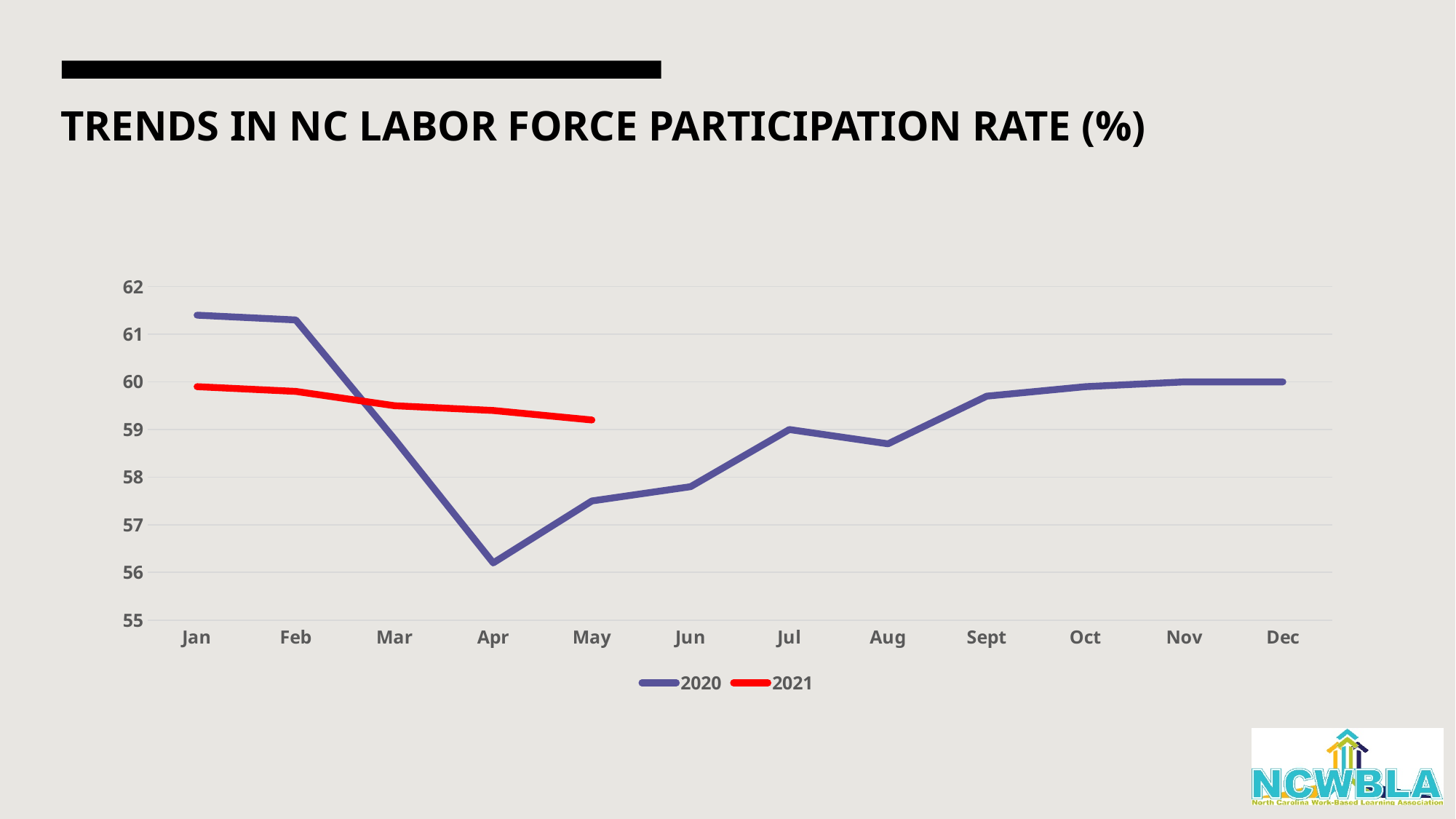
Is the 2020 value for Apr greater or less than 57? less Which series has the higher value in Apr, 2020 or 2021? 2021 Does the 2021 line rise or fall from Jan to May? fall In which month is the 2020 labor force participation rate lowest? Apr Is the 2021 value for May greater or less than 60? less What kind of chart is shown on the slide? line chart How many series does the legend list? 2 How many months are shown along the x axis? 12 What colour is the line for the 2021 series? red For how many months does the 2021 series have data points? 5 In which month is the 2020 labor force participation rate highest? Jan Is the 2020 value for Jan greater or less than 61? greater